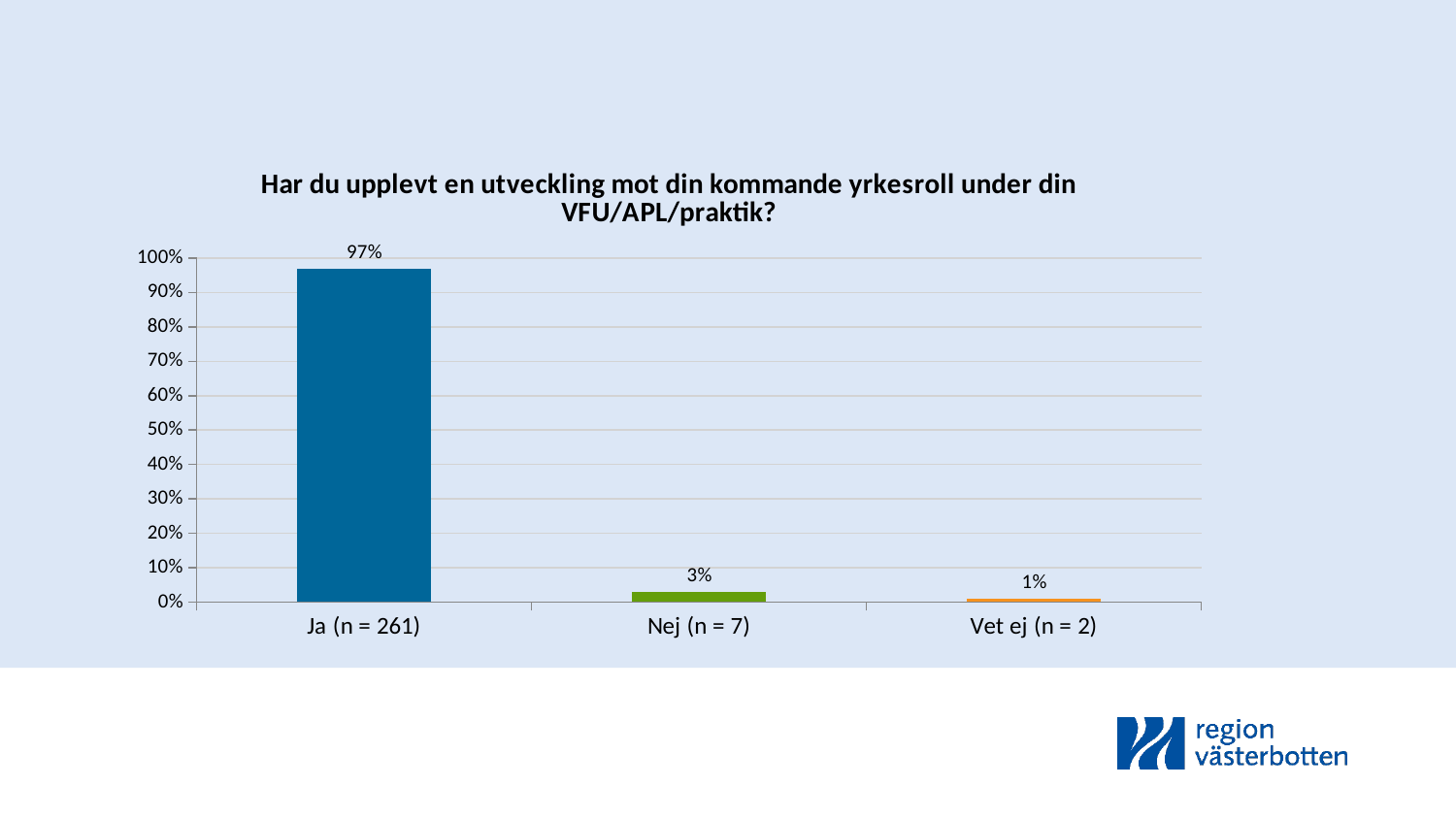
What is the value for "Vet ej (n = 2)"? 1% What is the value for "Nej (n = 7)"? 3% What is the difference between the values for "Ja (n = 261)" and "Nej (n = 7)"? 94% Which is larger, the value for "Nej (n = 7)" or the value for "Vet ej (n = 2)"? Nej (n = 7) How many categories are shown on the x axis? 3 What is the value for "Ja (n = 261)"? 97% What is the difference between the values for "Nej (n = 7)" and "Vet ej (n = 2)"? 2% What kind of chart is shown on the slide? bar chart What is the title of the chart? Har du upplevt en utveckling mot din kommande yrkesroll under din VFU/APL/praktik? Which category has the highest value? Ja (n = 261) Which category has the lowest value? Vet ej (n = 2) Is the value for "Ja (n = 261)" greater or less than 90%? greater